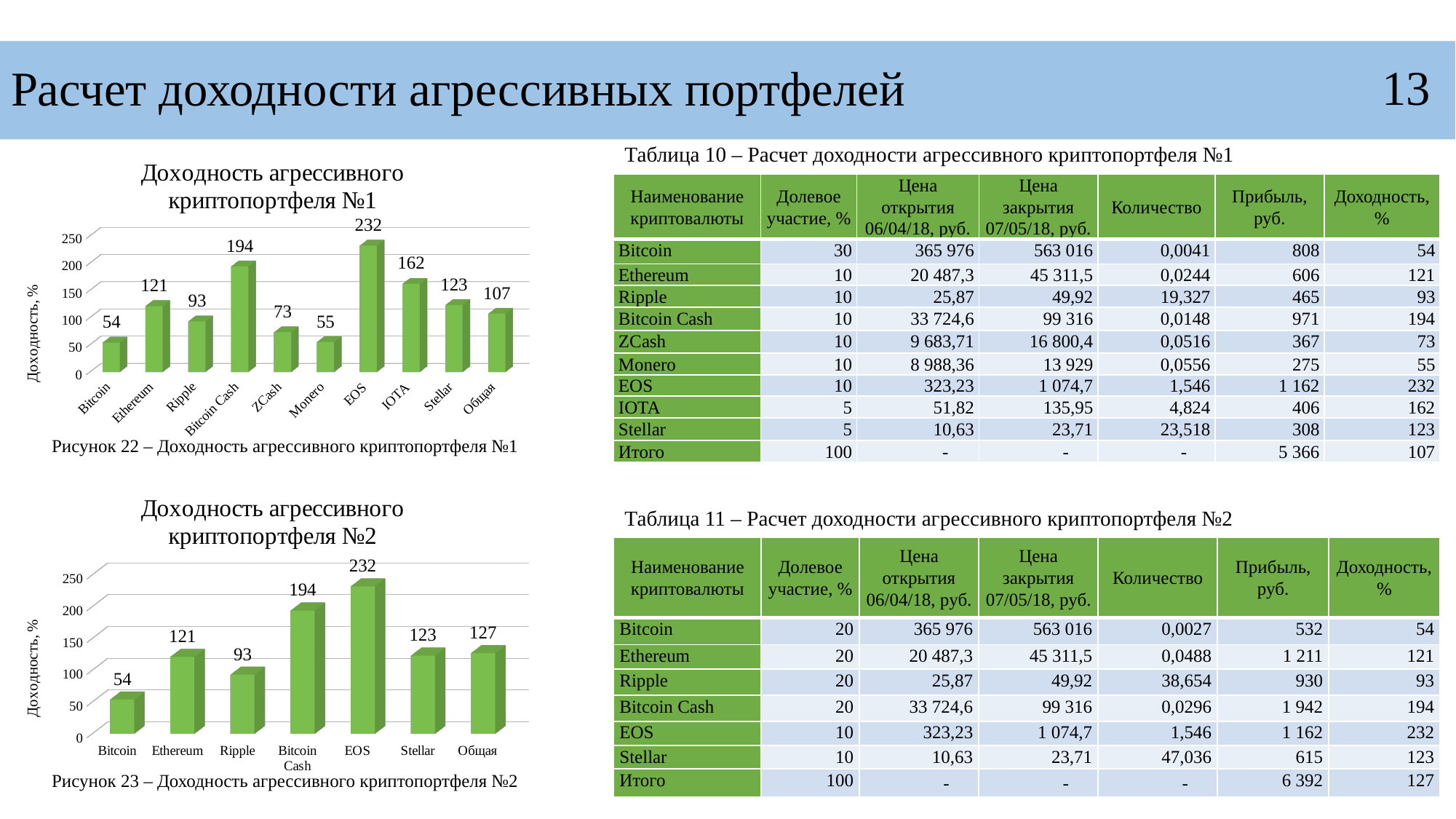
In the chart 'Доходность агрессивного криптопортфеля №1', what is the difference between the values for Bitcoin Cash and ZCash? 121 What kind of chart is 'Доходность агрессивного криптопортфеля №2'? Bar chart In the chart 'Доходность агрессивного криптопортфеля №2', how many categories are shown on the x axis? 7 In the chart 'Доходность агрессивного криптопортфеля №2', which category has the highest value? EOS What is the y-axis label of the chart 'Доходность агрессивного криптопортфеля №1'? Доходность, % In the chart 'Доходность агрессивного криптопортфеля №1', which category has the lowest value? Bitcoin In the chart 'Доходность агрессивного криптопортфеля №1', which is larger, the value for Monero or the value for Ripple? Ripple In the chart 'Доходность агрессивного криптопортфеля №1', how many categories are shown on the x axis? 10 In the chart 'Доходность агрессивного криптопортфеля №1', what is the value for IOTA? 162 In the chart 'Доходность агрессивного криптопортфеля №1', what is the value for EOS? 232 In the chart 'Доходность агрессивного криптопортфеля №2', what is the difference between the values for Ethereum and Bitcoin? 67 In the chart 'Доходность агрессивного криптопортфеля №2', what is the value for Общая? 127